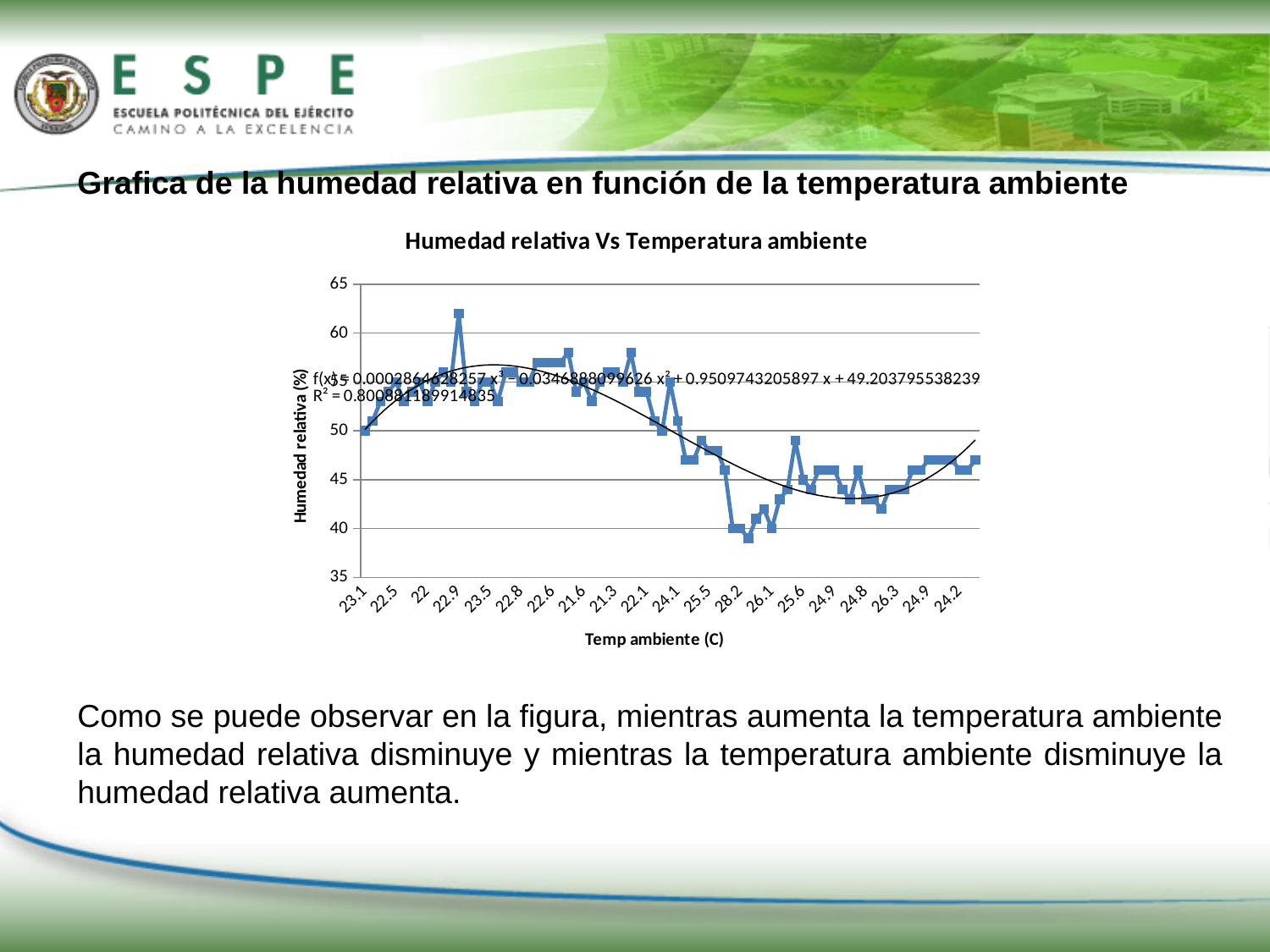
Is the relative humidity value at the last x-axis label, 24.2, greater or less than 50? less What is the highest value shown on the y-axis of the chart? 65 What kind of chart is shown on the slide? line chart At which x-axis label does the relative humidity reach its highest point? 22.9 Do the relative humidity values generally rise or fall from the left side of the chart to the right side? fall Which has the higher relative humidity: the point at x-axis label 23.1 or the point at x-axis label 28.2? 23.1 Is the relative humidity value at the first x-axis label, 23.1, greater or less than 45? greater What R² value is printed on the chart for the trendline? 0.800881189914835 Is the relative humidity value at the x-axis label 28.2 greater or less than 45? less What is the title of the chart? Humedad relativa Vs Temperatura ambiente